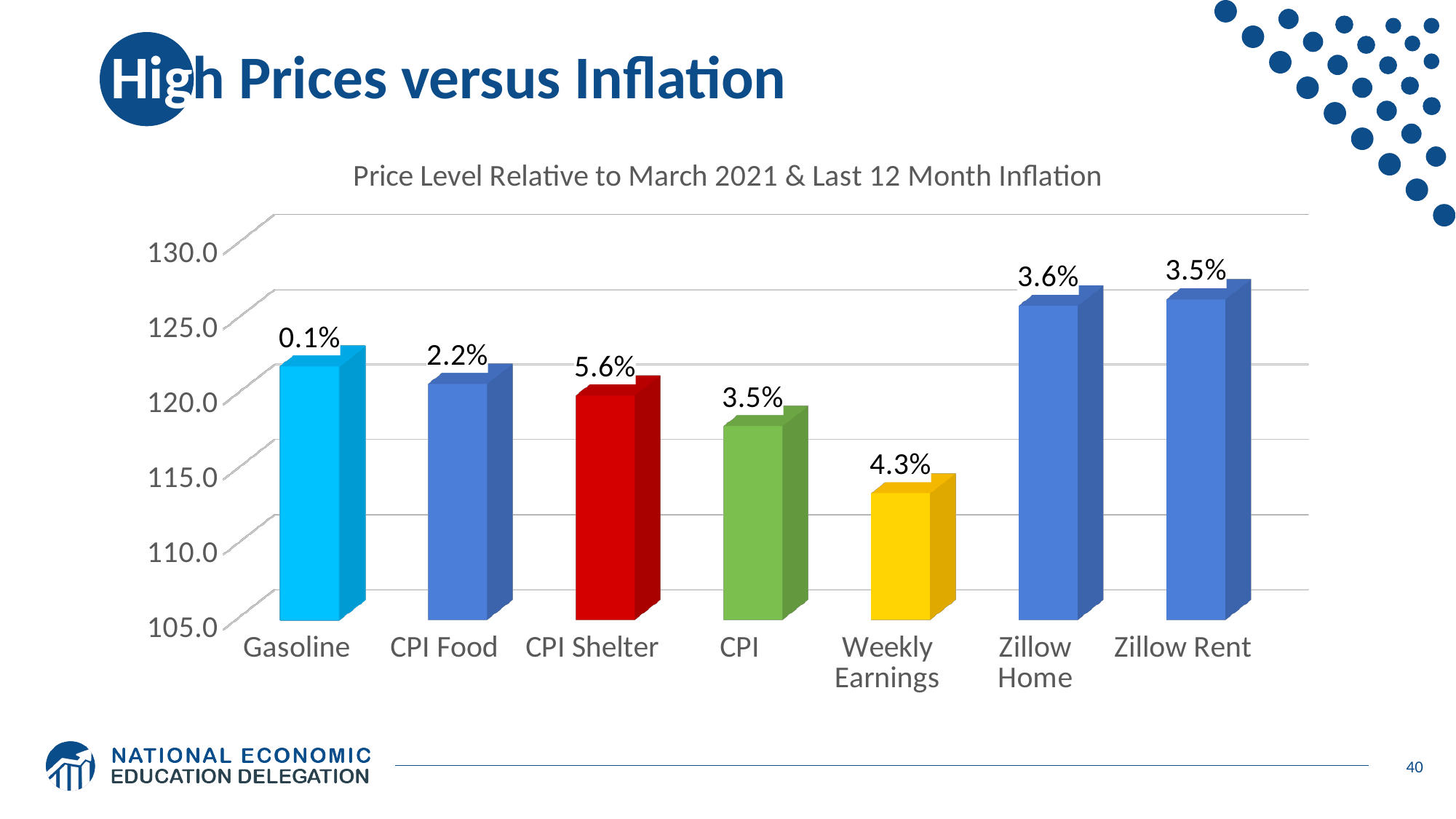
Is the price level bar for Weekly Earnings greater or less than 115.0? less What is the last 12 month inflation figure printed above the Zillow Home bar? 3.6% What is the difference between the inflation figures printed above the CPI Shelter and Gasoline bars? 5.5 percentage points How many categories are plotted on the chart? 7 Which category has the lowest last 12 month inflation figure printed above its bar? Gasoline Which category has the lowest bar (price level relative to March 2021)? Weekly Earnings What is the last 12 month inflation figure printed above the CPI Shelter bar? 5.6% What kind of chart is shown on the slide? Bar chart What is the last 12 month inflation figure printed above the Gasoline bar? 0.1% What is the last 12 month inflation figure printed above the Weekly Earnings bar? 4.3% Which category has the highest last 12 month inflation figure printed above its bar? CPI Shelter What is the title of the chart? Price Level Relative to March 2021 & Last 12 Month Inflation